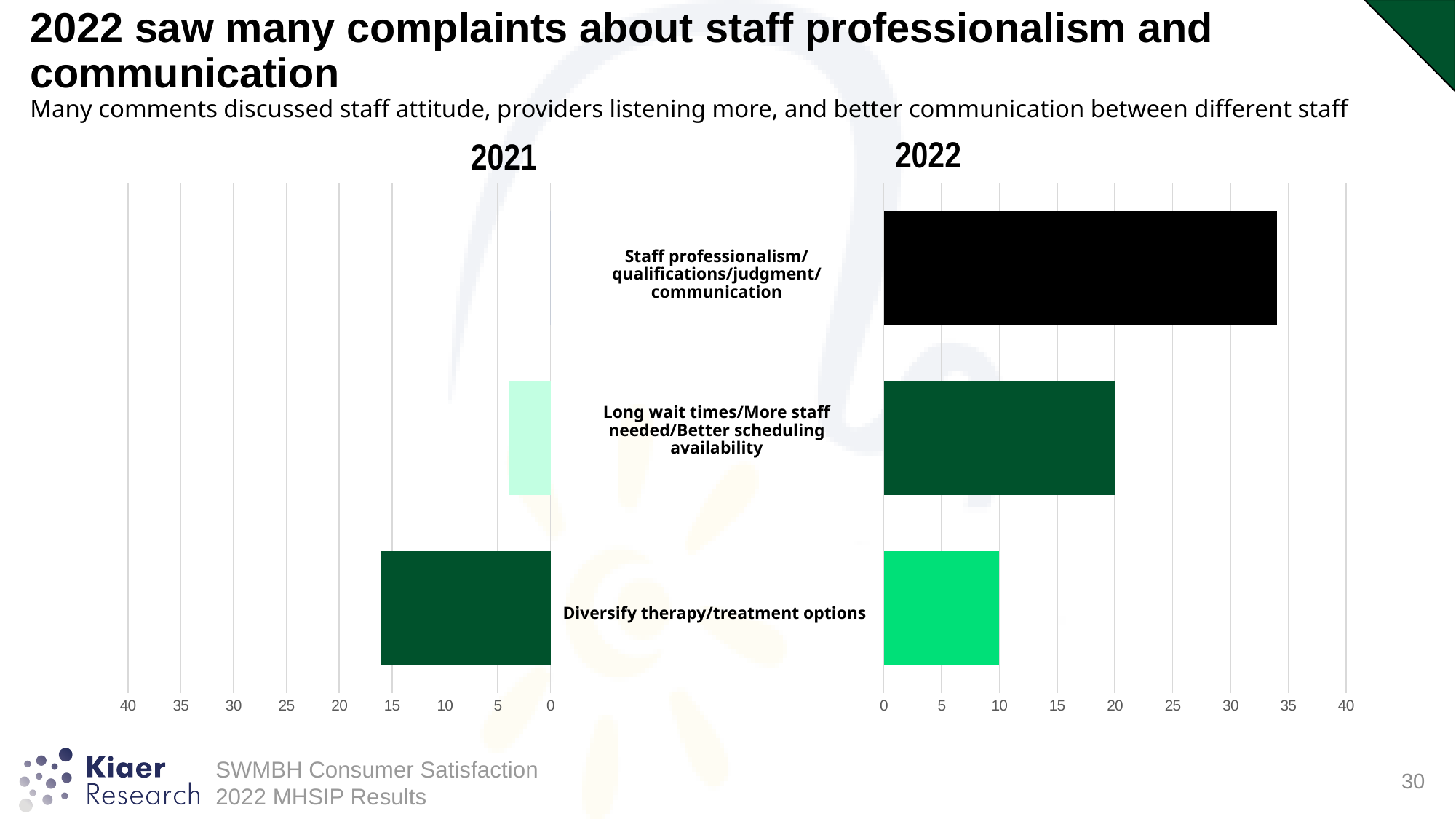
In the 2022 chart, which category has the lowest value? Diversify therapy/treatment options How many categories are shown in the 2022 chart? 3 In the 2021 chart, which category has the highest value? Diversify therapy/treatment options In the 2022 chart, is the value for Staff professionalism/qualifications/judgment/communication greater or less than 30? greater In the 2022 chart, which category has the highest value? Staff professionalism/qualifications/judgment/communication What kind of chart is used for the 2021 and 2022 panels on this slide? bar chart In the 2022 chart, which is larger: Long wait times/More staff needed/Better scheduling availability or Diversify therapy/treatment options? Long wait times/More staff needed/Better scheduling availability In the 2022 chart, what is the value for Long wait times/More staff needed/Better scheduling availability? 20 In the 2021 chart, is the value for Long wait times/More staff needed/Better scheduling availability greater or less than 5? less In the 2021 chart, is the value for Diversify therapy/treatment options greater or less than 15? greater In the 2022 chart, what is the value for Diversify therapy/treatment options? 10 In the 2022 chart, what is the difference between Long wait times/More staff needed/Better scheduling availability and Diversify therapy/treatment options? 10